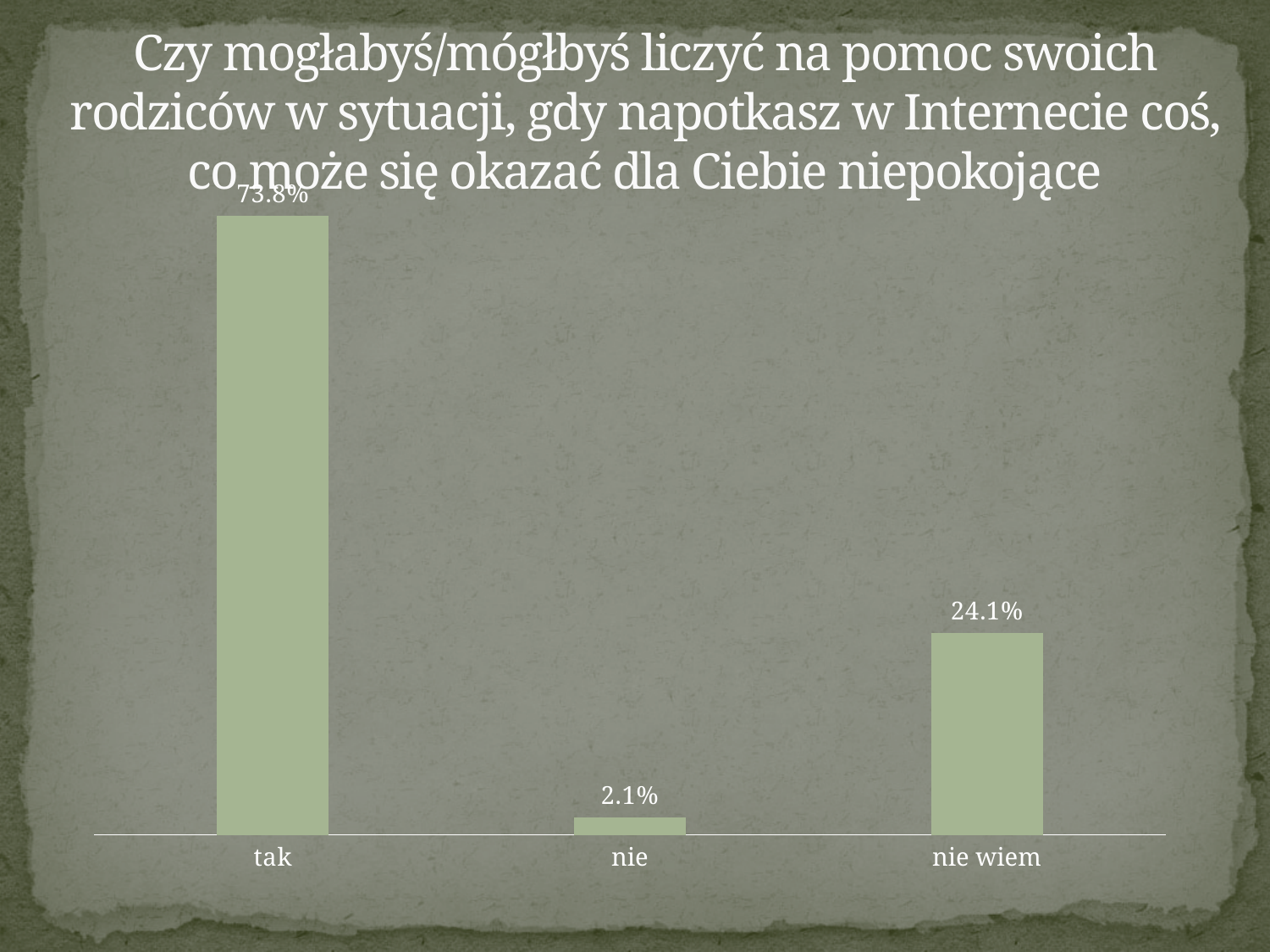
What are the category labels on the x axis, from left to right? tak, nie, nie wiem What is the value for "nie wiem"? 24.1% What kind of chart is shown on the slide? bar chart Which category has the lowest value? nie What is the difference between the values for "nie wiem" and "nie"? 22.0% How many categories are shown on the chart? 3 What is the value for "nie"? 2.1% What is the total of the three values shown on the chart? 100.0% Which is larger, the value for "nie" or the value for "nie wiem"? nie wiem What is the value for "tak"? 73.8% What is the difference between the values for "tak" and "nie wiem"? 49.7% Which category has the highest value? tak